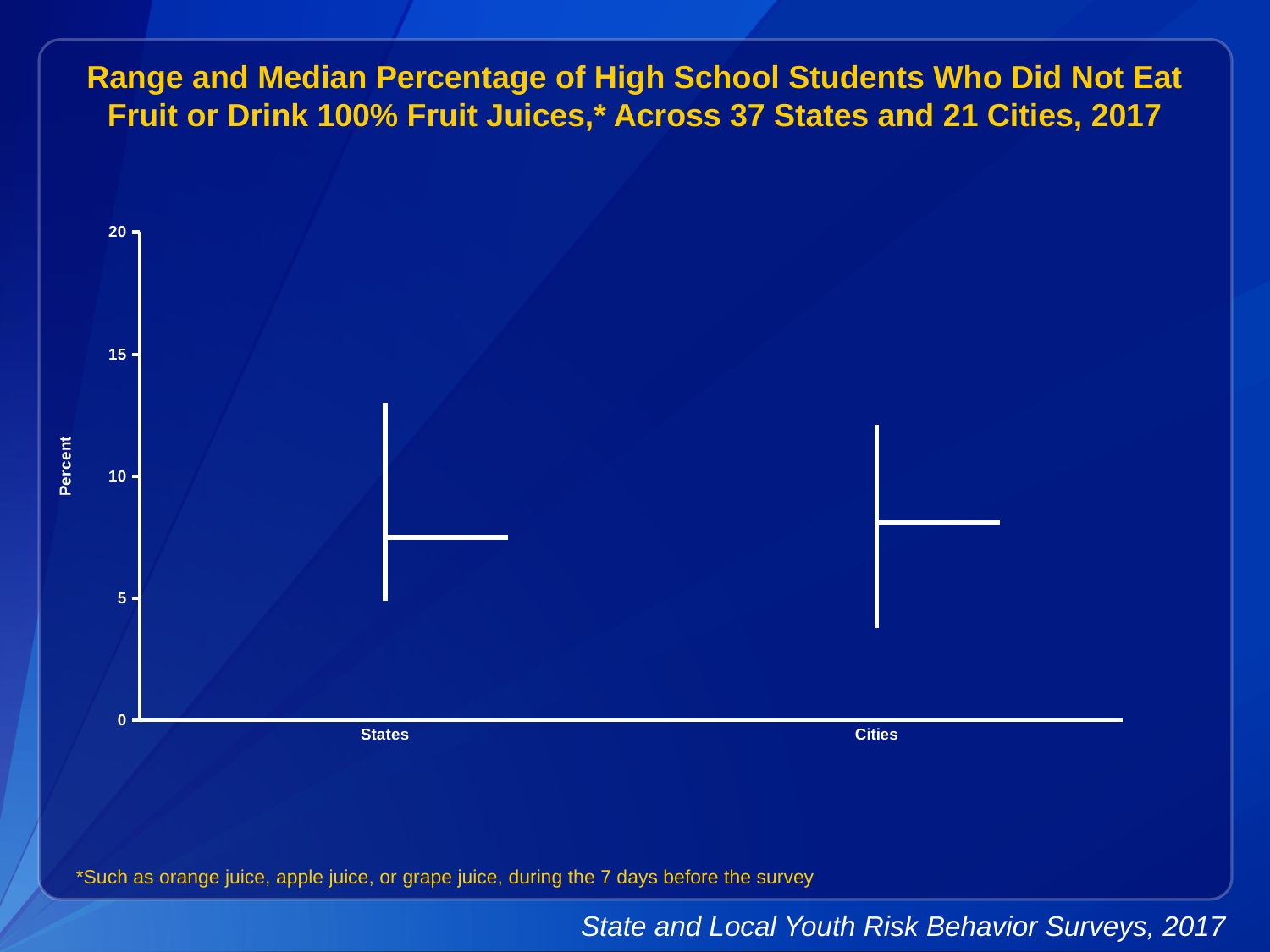
Is the top of the range for States greater or less than 15? less Which category has the lower bottom of its range, States or Cities? Cities What are the two categories shown on the x axis? States and Cities What is the highest value shown on the y axis? 20 What is the label of the y axis? Percent Is the top of the range for States greater or less than 10? greater Is the median value for Cities greater or less than 10? less How many categories are shown on the x axis of the chart? 2